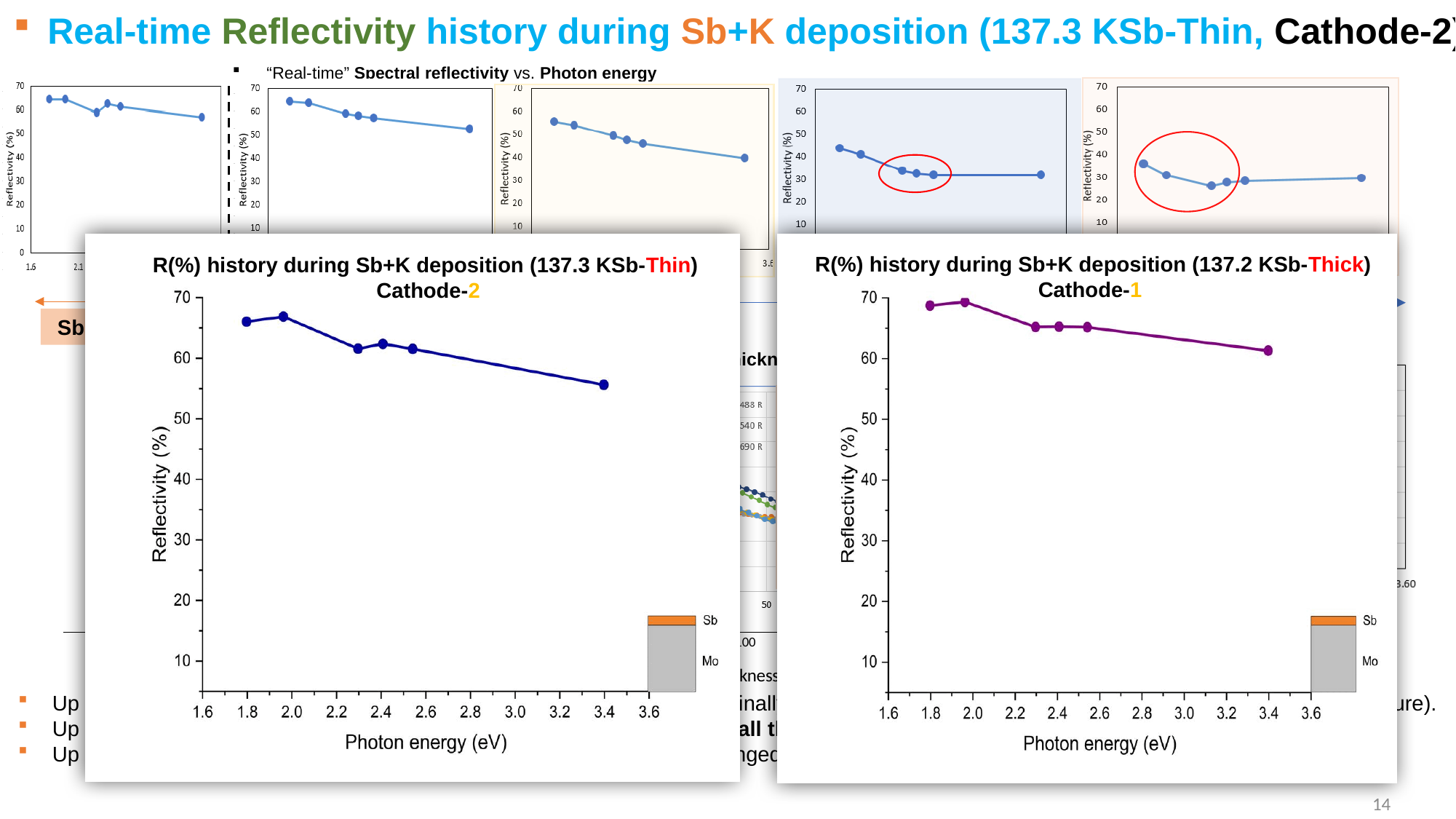
In the 'R(%) history during Sb+K deposition (137.3 KSb-Thin) Cathode-2' chart, at which photon energy is the reflectivity lowest? 3.4 eV In the 'R(%) history during Sb+K deposition (137.3 KSb-Thin) Cathode-2' chart, is the reflectivity at 3.4 eV greater or less than 60? less How many data points are plotted in the 'R(%) history during Sb+K deposition (137.3 KSb-Thin) Cathode-2' chart? 6 What is the y-axis label of the 'R(%) history during Sb+K deposition (137.3 KSb-Thin) Cathode-2' chart? Reflectivity (%) How many data points are plotted in the 'R(%) history during Sb+K deposition (137.2 KSb-Thick) Cathode-1' chart? 6 At 3.4 eV, which chart shows the higher reflectivity: the 137.3 KSb-Thin Cathode-2 chart or the 137.2 KSb-Thick Cathode-1 chart? 137.2 KSb-Thick Cathode-1 What is the x-axis label of the 'R(%) history during Sb+K deposition (137.2 KSb-Thick) Cathode-1' chart? Photon energy (eV) What kind of chart is the 'R(%) history during Sb+K deposition (137.3 KSb-Thin) Cathode-2' chart? line chart In the 'R(%) history during Sb+K deposition (137.2 KSb-Thick) Cathode-1' chart, do the reflectivity values generally rise or fall as photon energy increases? fall In the 'R(%) history during Sb+K deposition (137.2 KSb-Thick) Cathode-1' chart, is the reflectivity at 3.4 eV greater or less than 60? greater In the 'R(%) history during Sb+K deposition (137.3 KSb-Thin) Cathode-2' chart, do the reflectivity values generally rise or fall as photon energy increases? fall In the 'R(%) history during Sb+K deposition (137.3 KSb-Thin) Cathode-2' chart, is the reflectivity at 1.8 eV greater or less than 60? greater